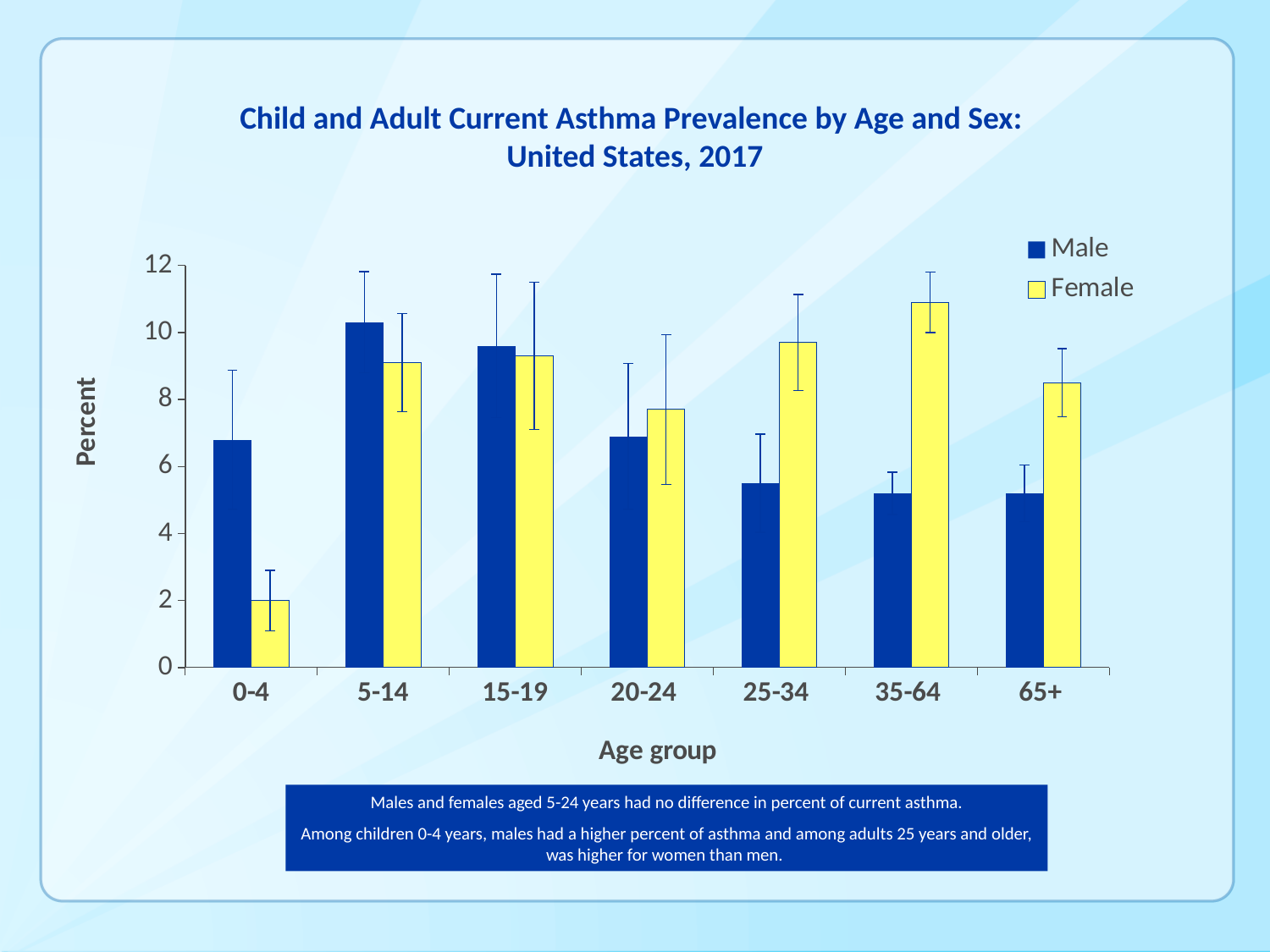
Is the Female value for the 0-4 age group greater or less than 4? less Which age group has the highest Female value? 35-64 Is the Female value for the 35-64 age group greater or less than 10? greater In the 65+ age group, which is larger, the Male or the Female value? Female What is the label of the y axis? Percent In the 0-4 age group, which is larger, the Male or the Female value? Male What kind of chart is shown on the slide? Bar chart Which age group has the highest Male value? 5-14 How many age groups are shown on the x axis? 7 How many series does the legend list? 2 Is the Male value for the 25-34 age group greater or less than 6? less Which age group has the lowest Female value? 0-4